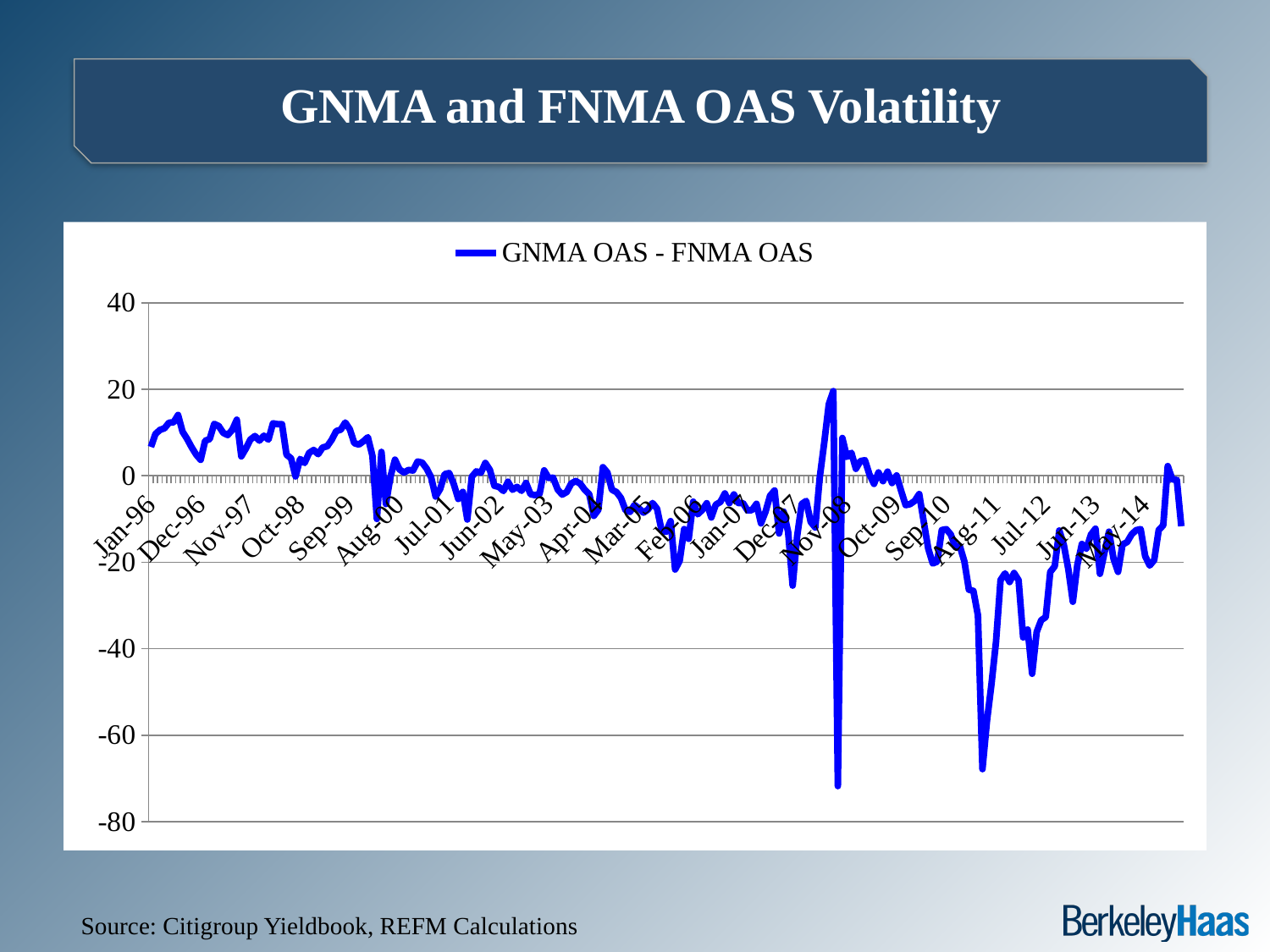
How many date labels are shown on the x axis? 21 Overall, do the values rise or fall from Jan-96 to May-14? fall What is the title of the chart? GNMA and FNMA OAS Volatility Is the value for Sep-99 greater or less than 0? greater How many series does the legend list? 1 Is the highest value of the series greater or less than 40? less What kind of chart is shown on the slide? line chart Is the lowest value of the series, reached around Nov-08, greater or less than -60? less What is the name of the series shown in the legend? GNMA OAS - FNMA OAS